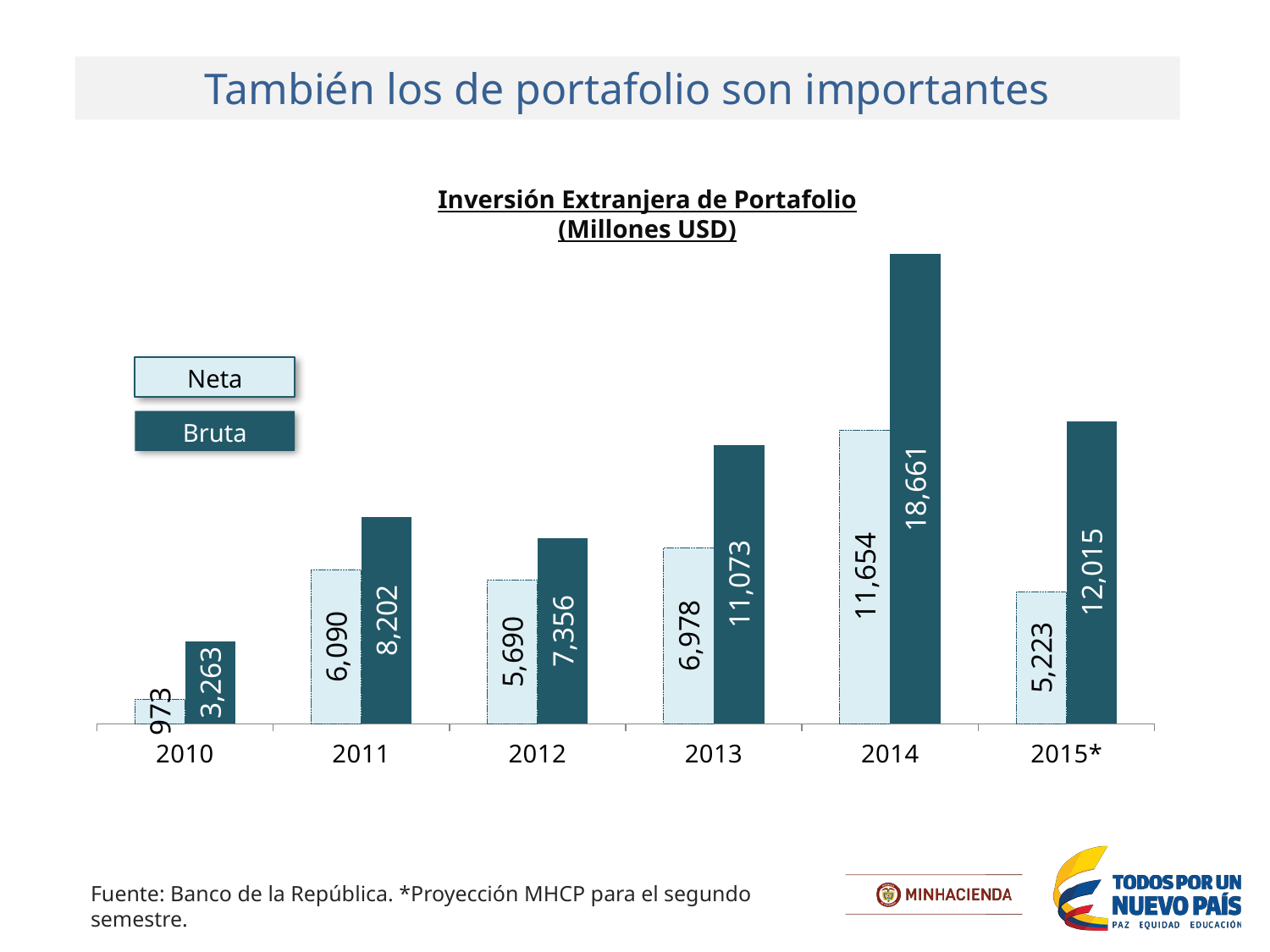
How many series does the legend list? 2 Which year has the lowest Neta value? 2010 What is the Neta value for 2012? 5,690 What kind of chart is shown? Bar chart What is the difference between the Bruta and Neta values in 2013? 4,095 What is the Bruta value for 2014? 18,661 How many years are shown on the x axis? 6 Which year has the highest Bruta value? 2014 What is the difference between the Bruta values for 2014 and 2015*? 6,646 What is the title of the chart? Inversión Extranjera de Portafolio (Millones USD) Which is larger, the Neta value for 2011 or the Neta value for 2012? 2011 What is the Neta value for 2015*? 5,223